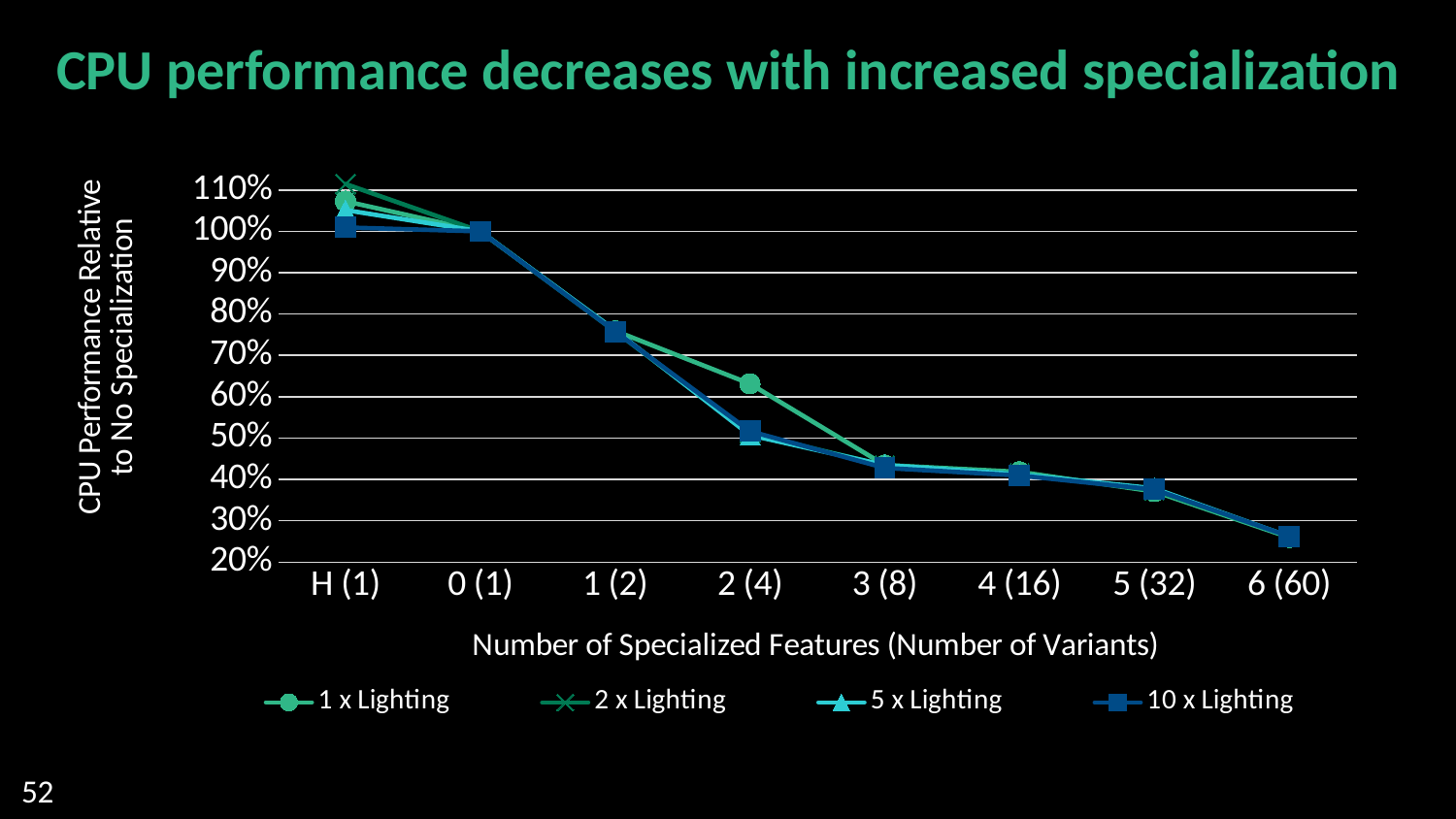
What is the value for 10 x Lighting at 0 (1)? 100% At 2 (4), which series has the larger value, 1 x Lighting or 10 x Lighting? 1 x Lighting Is the value for 10 x Lighting at 1 (2) greater or less than 70%? greater What is the title of the x axis? Number of Specialized Features (Number of Variants) For the 2 x Lighting series, which category has the lowest value? 6 (60) Is the value for 1 x Lighting at 2 (4) greater or less than 60%? greater What kind of chart is shown on the slide? line chart Do the values generally rise or fall from left to right along the x axis? fall How many categories are shown on the x axis? 8 How many series does the legend list? 4 Is the value for 10 x Lighting at 5 (32) greater or less than 40%? less